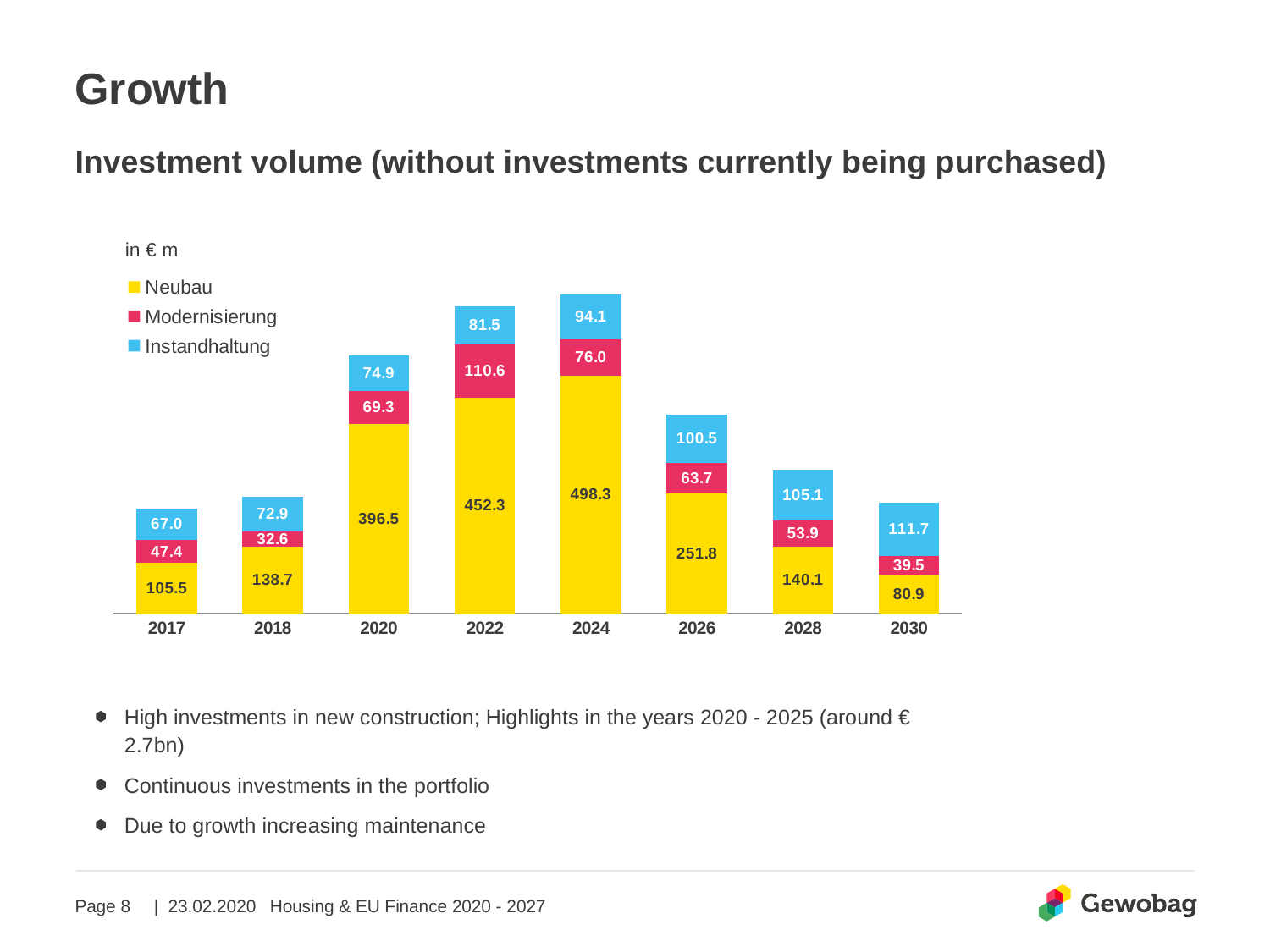
What is the total of the stacked bar for 2017? 219.9 What is the Neubau value for 2024? 498.3 Which is larger, the Instandhaltung value for 2026 or for 2028? 2028 Which year has the highest Neubau value? 2024 How many series does the legend list? 3 What is the difference between the Neubau values for 2022 and 2020? 55.8 What is the Modernisierung value for 2022? 110.6 What kind of chart is shown on the slide? Stacked bar chart How many years are shown on the x axis? 8 Which series is shown in yellow? Neubau What is the Instandhaltung value for 2030? 111.7 Which year has the lowest Modernisierung value? 2018